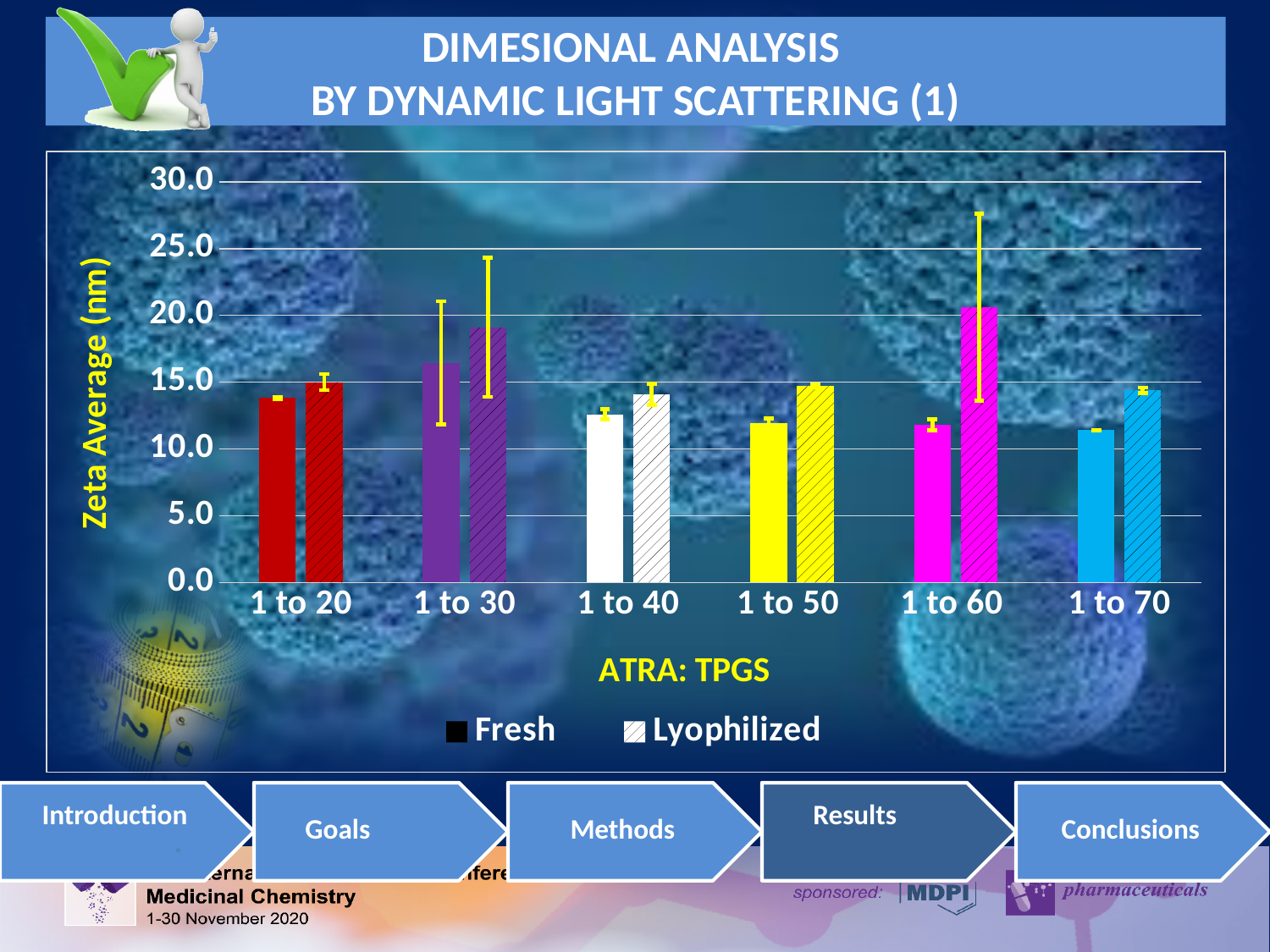
Is the Fresh value for 1 to 70 greater or less than 15.0? less Which is larger, the Fresh value for 1 to 30 or the Fresh value for 1 to 20? 1 to 30 For the 1 to 60 category, which is larger, the Fresh value or the Lyophilized value? Lyophilized Is the Fresh value for 1 to 30 greater or less than 15.0? greater How many ATRA:TPGS ratio categories are shown on the x axis? 6 What kind of chart is shown on the slide? bar chart What is the title of the vertical axis? Zeta Average (nm) What are the two series named in the legend? Fresh and Lyophilized Is the Lyophilized value for 1 to 40 greater or less than 10.0? greater How many series does the legend list? 2 Which category has the highest Fresh value? 1 to 30